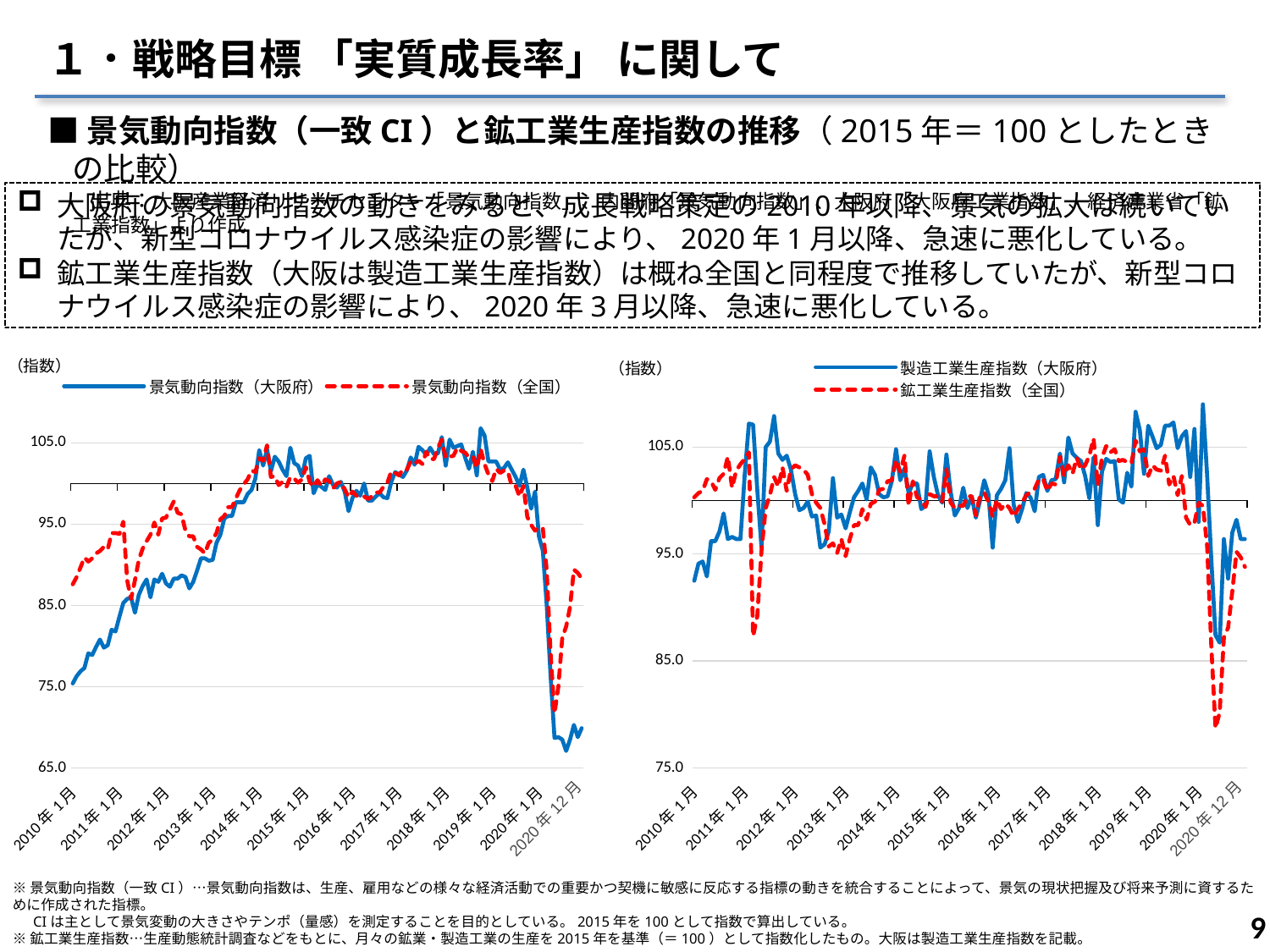
In the right chart, which series is drawn as a solid blue line? 製造工業生産指数（大阪府） In the right chart, is the lowest value of 鉱工業生産指数（全国） in 2020 greater or less than 85.0? less What kind of chart is the left chart (景気動向指数)? line chart In the right chart, is the value of 製造工業生産指数（大阪府） at 2010年1月 greater or less than 95.0? less How many series does the legend of the right chart (製造工業生産指数 / 鉱工業生産指数) list? 2 In the left chart (景気動向指数), does 景気動向指数（大阪府） rise or fall from 2010年1月 to 2014年1月? rise In the left chart (景気動向指数), which series is drawn as a dashed red line? 景気動向指数（全国） In the left chart (景気動向指数), at 2010年1月, which series has the higher value: 景気動向指数（大阪府） or 景気動向指数（全国）? 景気動向指数（全国） In the left chart (景気動向指数), is the value of 景気動向指数（大阪府） at 2010年1月 greater or less than 85.0? less How many series does the legend of the left chart (景気動向指数) list? 2